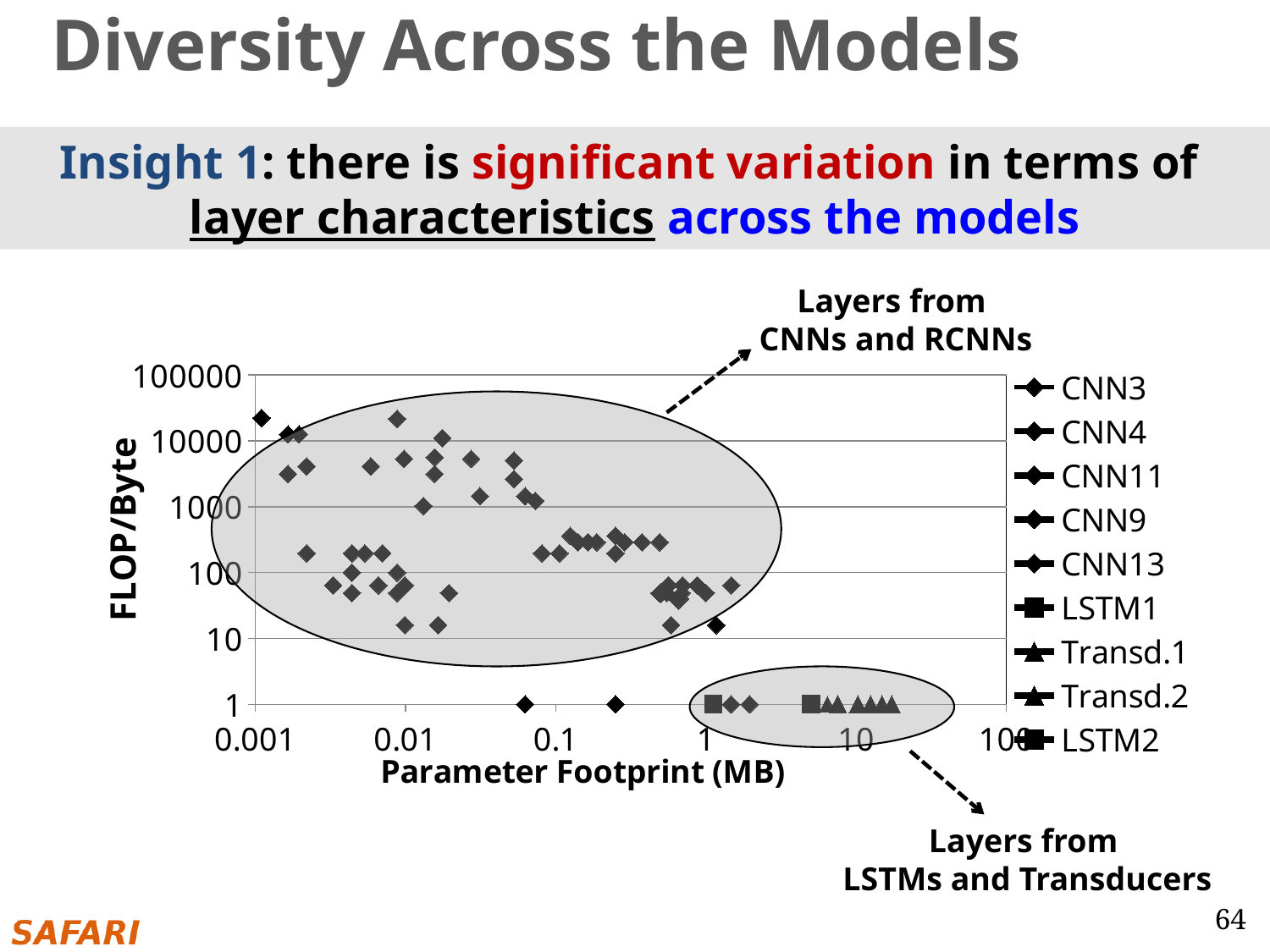
Which series is listed last in the chart's legend? LSTM2 What is the highest value shown on the vertical axis of the chart? 100000 What is the label of the chart's horizontal axis? Parameter Footprint (MB) How many tick values are labelled on the vertical axis of the chart? 6 What is the smallest value shown on the horizontal axis of the chart? 0.001 Is the FLOP/Byte value of the LSTM1 points greater or less than 10? less How many series does the chart's legend list? 9 What kind of chart is shown on the slide? scatter chart At what FLOP/Byte value do the LSTM and Transducer layer points lie on the chart? 1 Is the Parameter Footprint of the Transd.2 points greater or less than 1 MB? greater Which group of layers, CNN layers or LSTM layers, has the higher FLOP/Byte values on the chart? CNN layers What is the label of the chart's vertical axis? FLOP/Byte